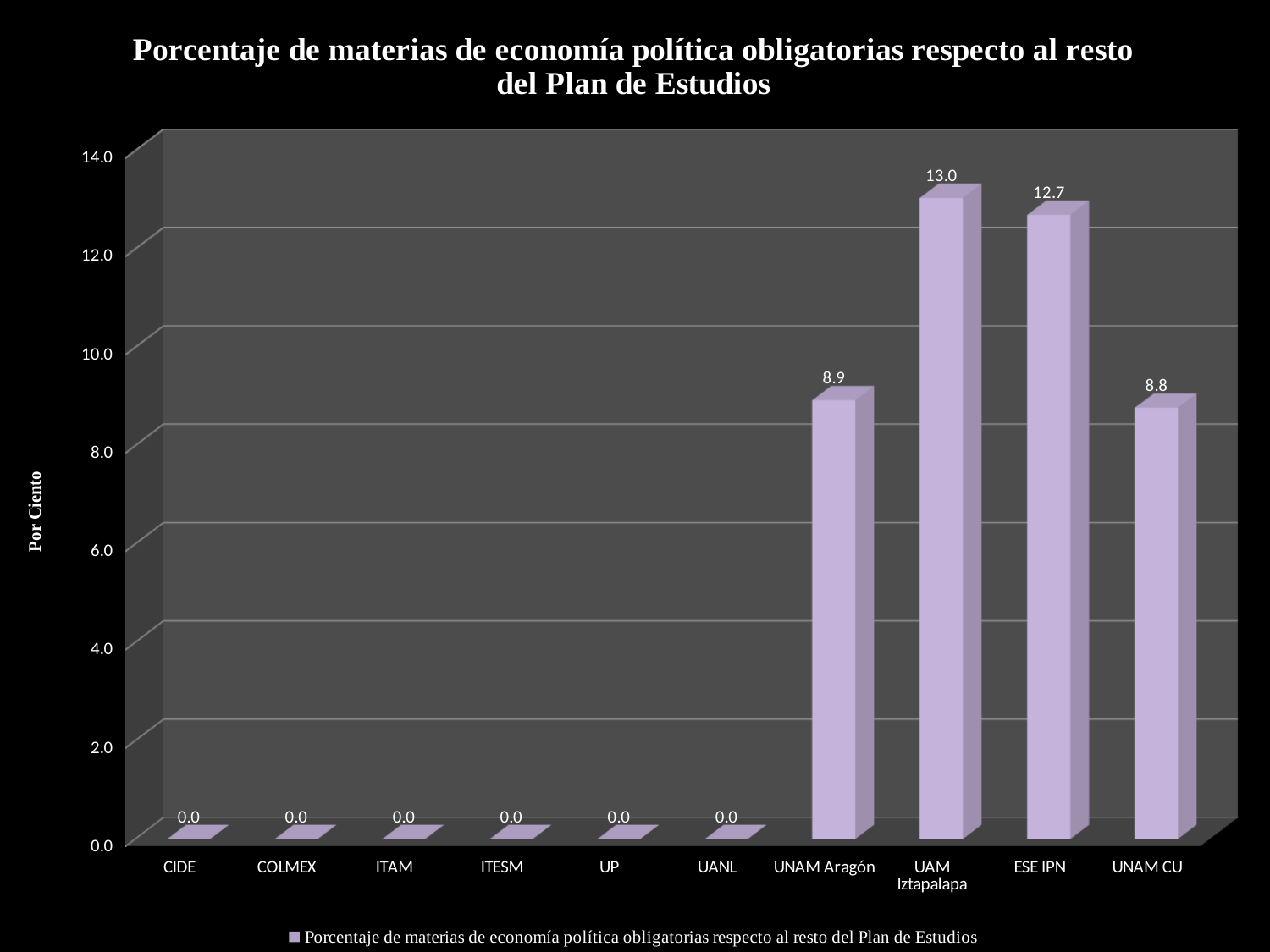
What is the value for UNAM CU? 8.8 What is the difference between the values for UAM Iztapalapa and ESE IPN? 0.3 How many categories are shown on the x axis? 10 What kind of chart is shown on the slide? Bar chart What is the value for UAM Iztapalapa? 13.0 What is the value for ESE IPN? 12.7 How many categories have a value of 0.0? 6 What is the value for CIDE? 0.0 What is the difference between the values for UNAM Aragón and UNAM CU? 0.1 Which is larger, the value for ESE IPN or the value for UNAM Aragón? ESE IPN Which category has the highest value? UAM Iztapalapa What is the value for UNAM Aragón? 8.9